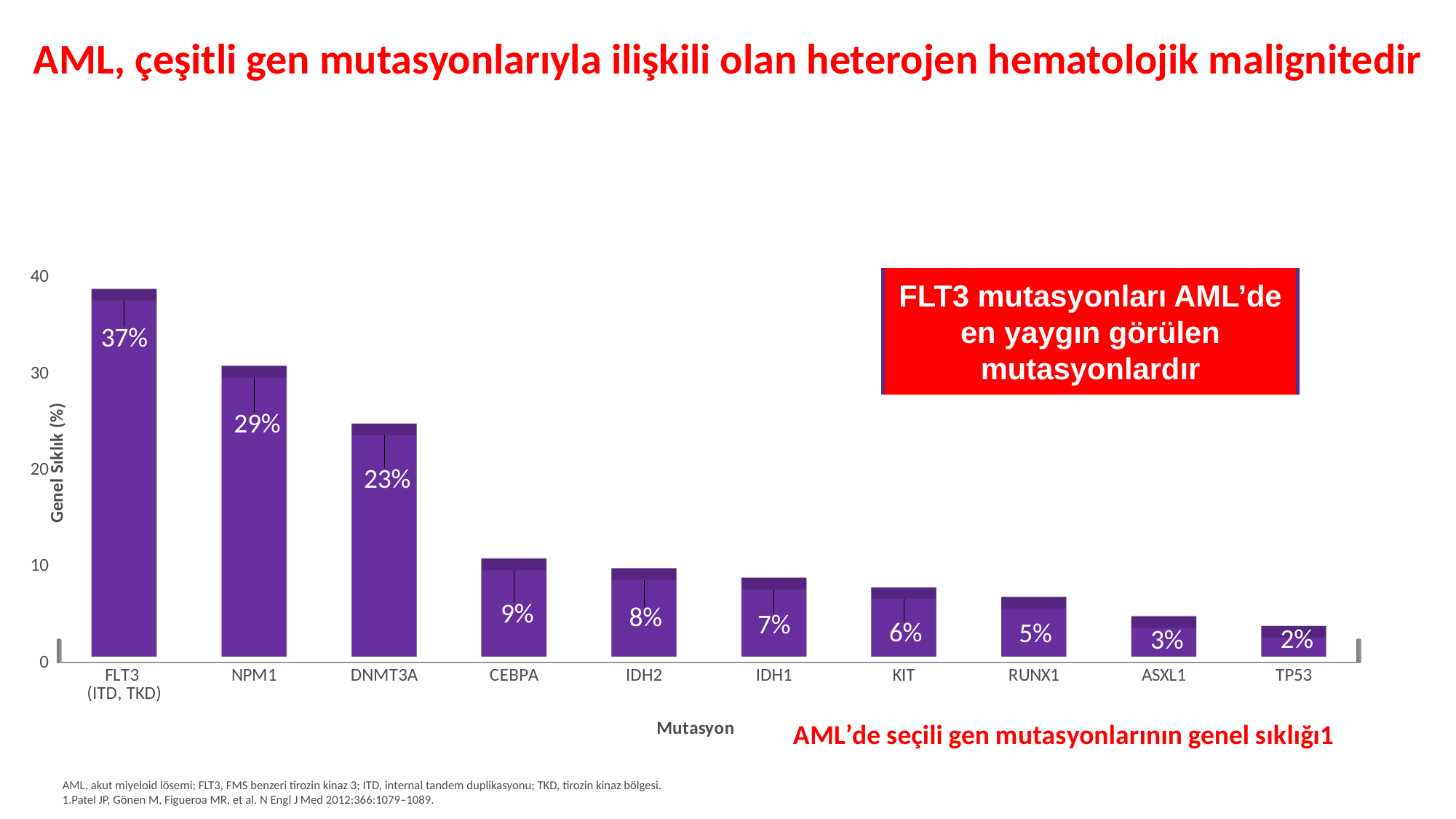
What is the value for DNMT3A? 23% What is the difference between the values for CEBPA and RUNX1? 4% Which is larger, the value for IDH2 or the value for IDH1? IDH2 Which mutation has the lowest overall frequency? TP53 Which mutation has the highest overall frequency? FLT3 (ITD, TKD) What is the value for KIT? 6% What is the label of the y axis? Genel Sıklık (%) Is the value for DNMT3A greater or less than 20? greater What is the value for NPM1? 29% How many mutations are shown on the x axis? 10 What is the difference between the values for FLT3 (ITD, TKD) and NPM1? 8% What kind of chart is shown on the slide? Bar chart